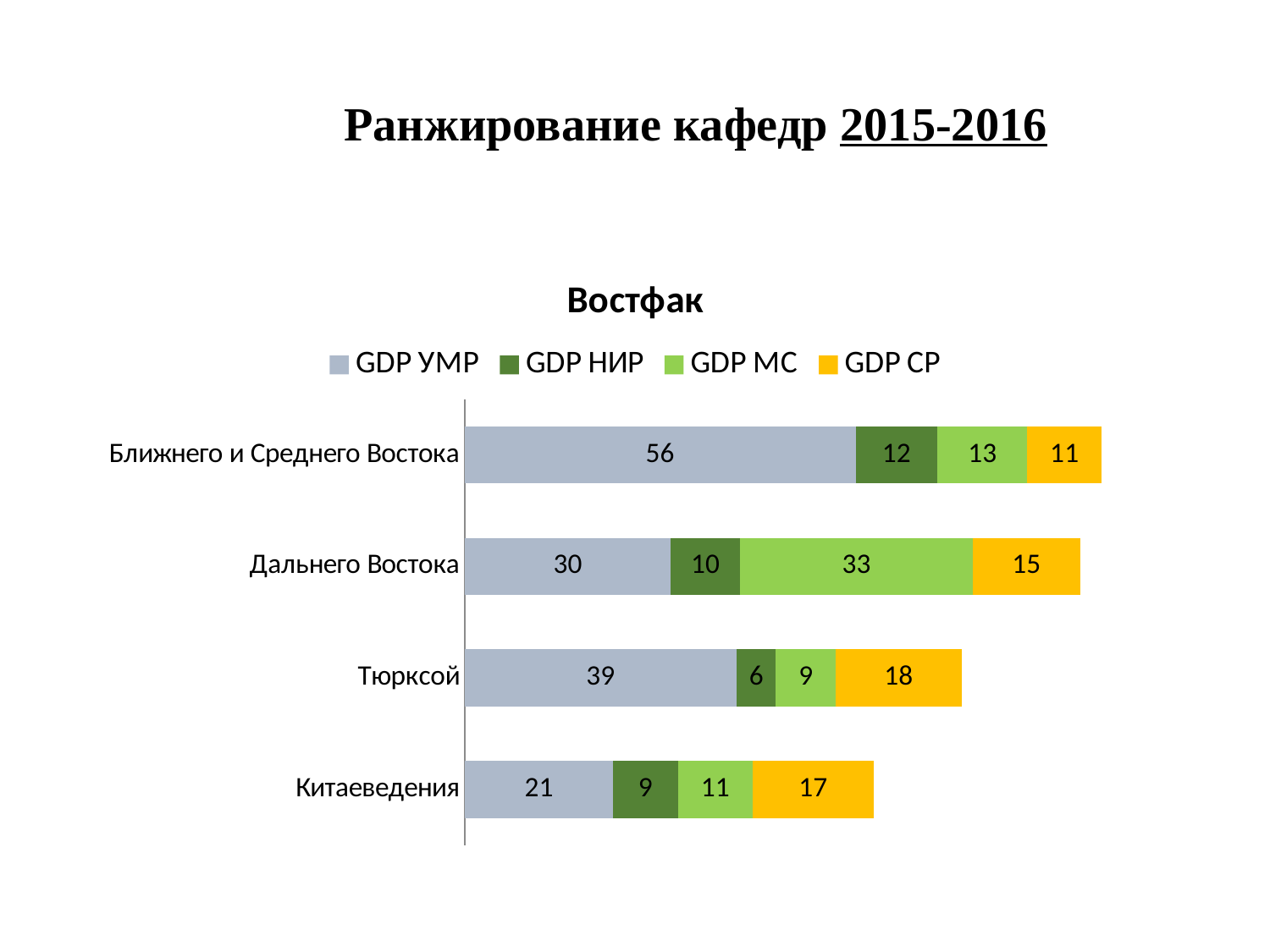
Which is larger: the GDP СР value for Китаеведения or for Дальнего Востока? Китаеведения What is the GDP НИР value for Китаеведения? 9 What is the total of the stacked bar for Дальнего Востока? 88 What is the GDP УМР value for Ближнего и Среднего Востока? 56 How many series does the legend list? 4 What is the GDP МС value for Дальнего Востока? 33 What is the GDP СР value for Тюрксой? 18 What is the difference between the GDP УМР values for Ближнего и Среднего Востока and Дальнего Востока? 26 How many categories are shown on the chart? 4 Which category has the lowest GDP НИР value? Тюрксой Which category has the highest GDP УМР value? Ближнего и Среднего Востока What is the total of the stacked bar for Китаеведения? 58